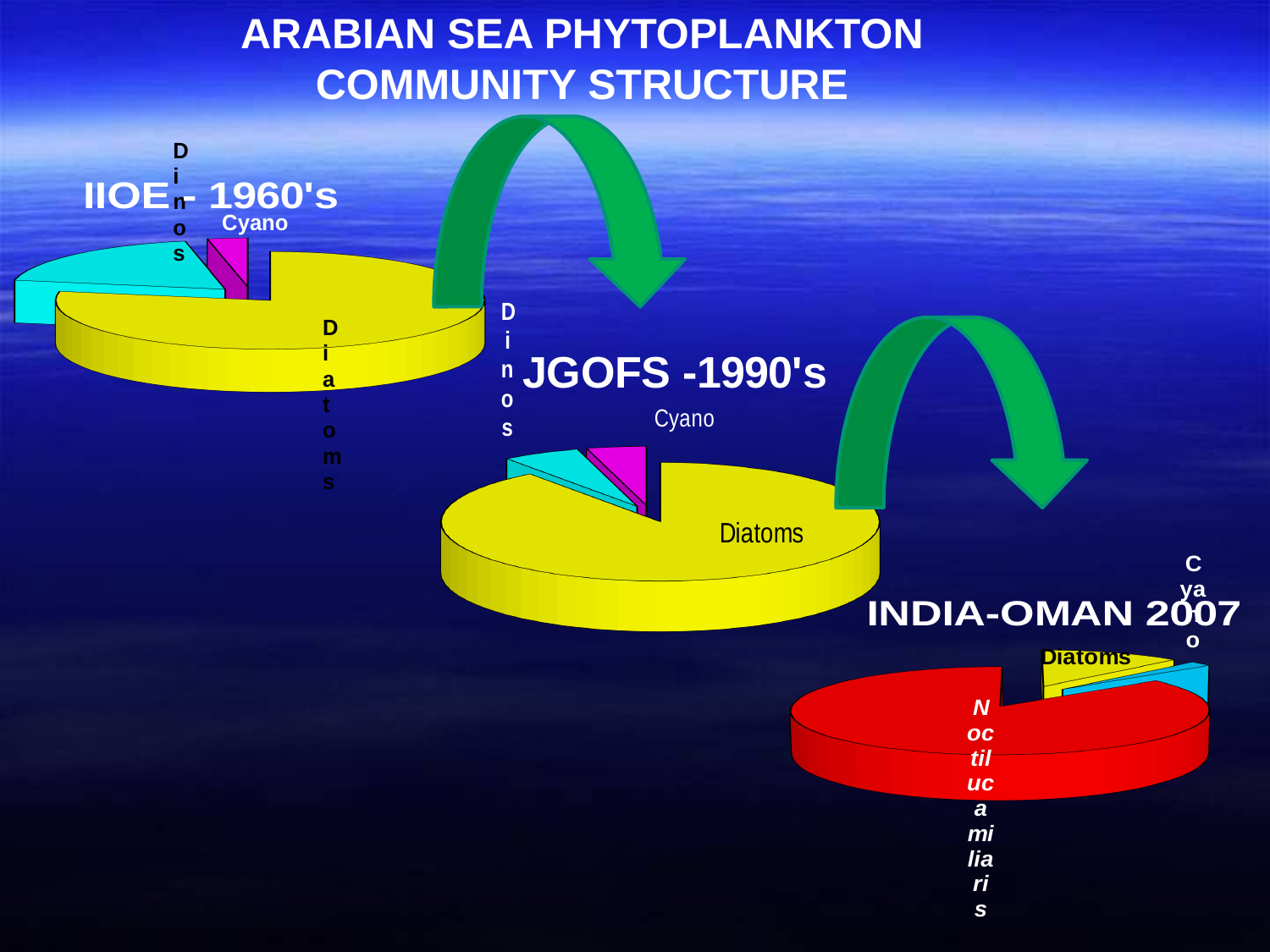
In the INDIA-OMAN 2007 pie chart, which slice is larger, Noctiluca miliaris or Diatoms? Noctiluca miliaris What is the title of the slide containing the three pie charts? ARABIAN SEA PHYTOPLANKTON COMMUNITY STRUCTURE What kind of chart is used for the IIOE - 1960's data? Pie chart How many slices does the IIOE - 1960's pie chart have? 3 How many pie charts are shown on the slide? 3 In the JGOFS - 1990's pie chart, which group has the largest slice? Diatoms In the INDIA-OMAN 2007 pie chart, which group has the largest slice? Noctiluca miliaris In the JGOFS - 1990's pie chart, which slice is larger, Dinos or Cyano? Dinos How many slices does the JGOFS - 1990's pie chart have? 3 In the IIOE - 1960's pie chart, which group has the smallest slice? Cyano In the IIOE - 1960's pie chart, which group has the largest slice? Diatoms What colour is the Noctiluca miliaris slice in the INDIA-OMAN 2007 pie chart? Red